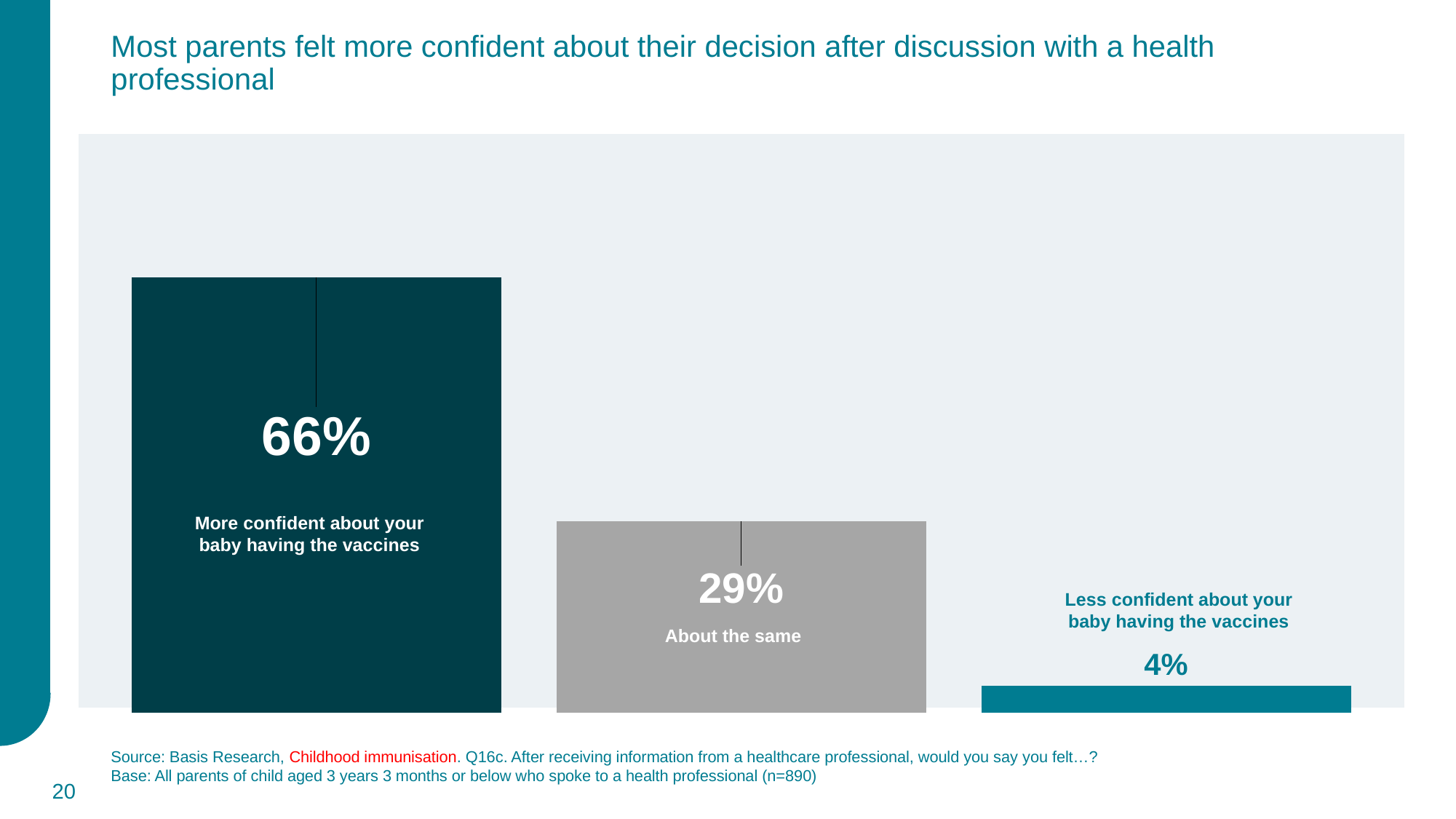
What is the base size (n) stated for the chart? n=890 How many response categories are shown in the chart? 3 Which response has the lowest percentage? Less confident about your baby having the vaccines Which is larger: the share who felt about the same or the share who felt less confident? About the same Which response has the highest percentage? More confident about your baby having the vaccines What percentage of parents felt more confident about their baby having the vaccines after speaking with a health professional? 66% What percentage of parents felt less confident about their baby having the vaccines? 4% Do the values rise or fall moving from left to right across the bars? Fall What is the difference in percentage points between 'About the same' and 'Less confident'? 25 What kind of chart is shown on the slide? Bar chart What percentage of parents said they felt about the same? 29% What is the difference in percentage points between 'More confident' and 'About the same'? 37